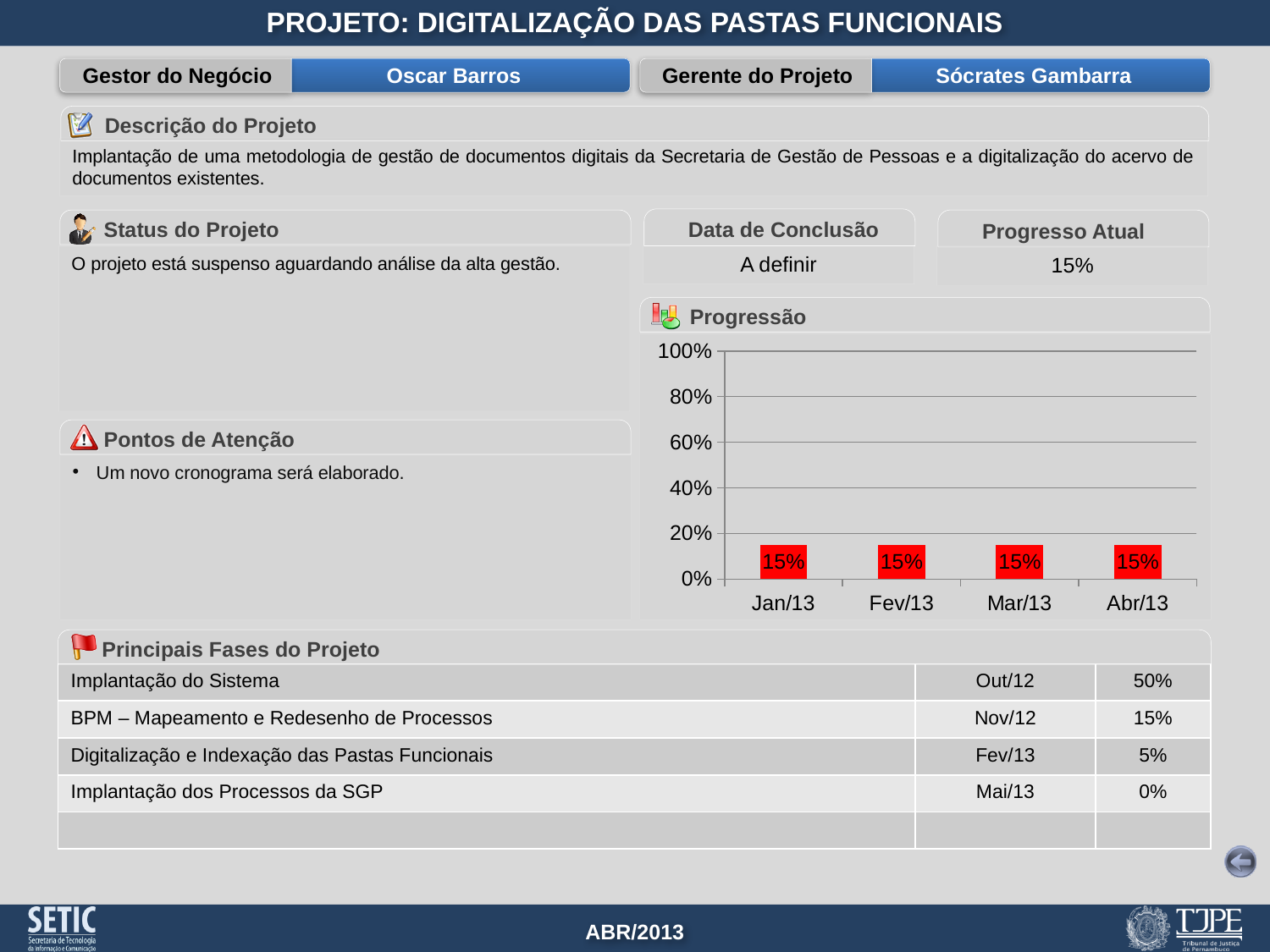
What kind of chart is the Progressão chart? bar chart What colour are the bars in the Progressão chart? red What is the value for Mar/13 in the Progressão chart? 15% What is the highest value shown on the vertical axis of the Progressão chart? 100% How many months are plotted in the Progressão chart? 4 What is the value for Jan/13 in the Progressão chart? 15% Is the value for Mar/13 in the Progressão chart greater or less than 20%? less Which month is the first category on the x axis of the Progressão chart? Jan/13 Do the values in the Progressão chart rise, fall or stay flat from Jan/13 to Abr/13? stay flat What is the difference between the values for Abr/13 and Jan/13 in the Progressão chart? 0% What is the value for Fev/13 in the Progressão chart? 15% What is the value for Abr/13 in the Progressão chart? 15%